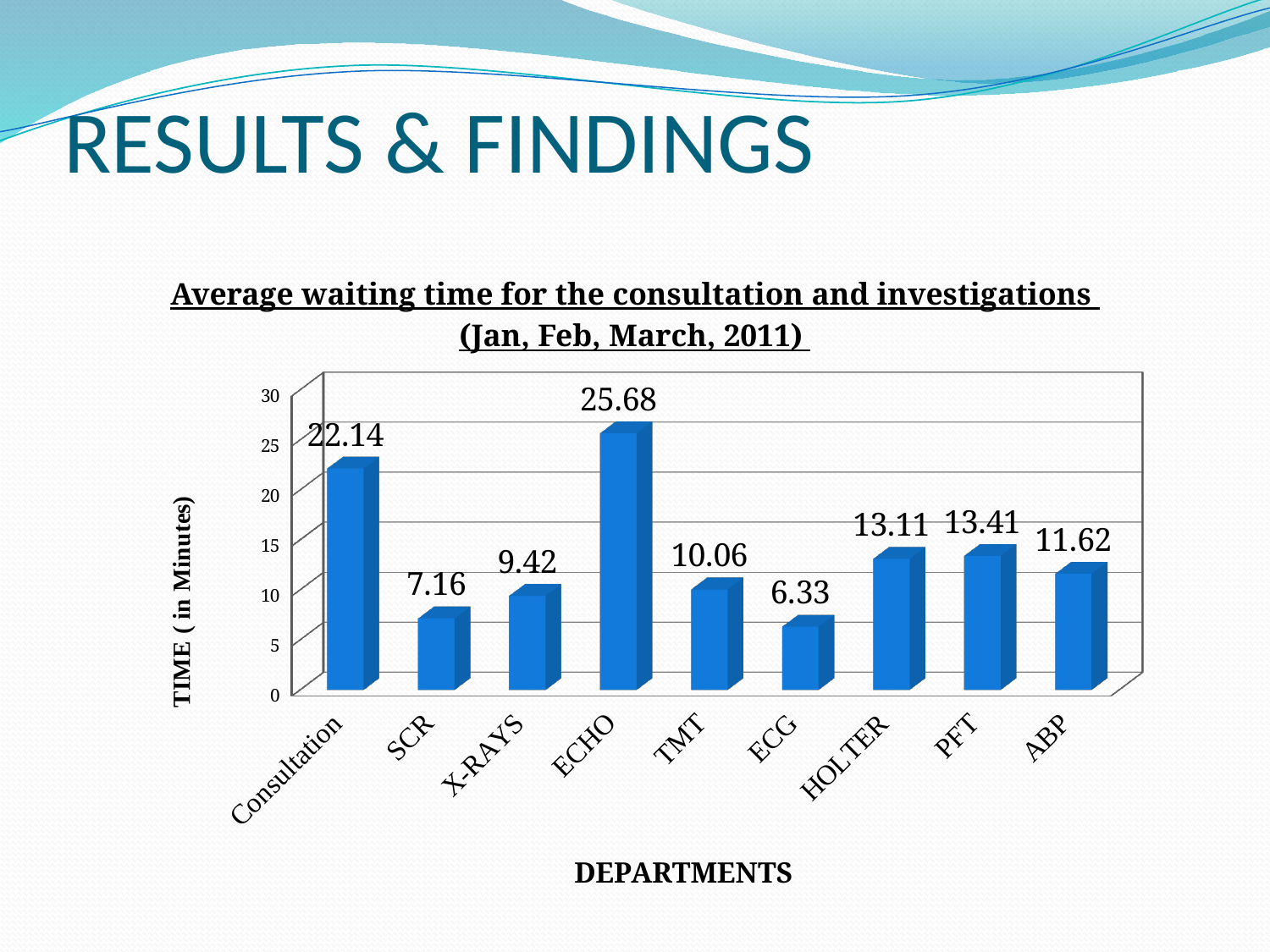
Which department has the lowest average waiting time? ECG Which has a longer average waiting time, PFT or ABP? PFT What is the difference in average waiting time between X-RAYS and SCR? 2.26 What is the average waiting time for HOLTER? 13.11 What is the label of the vertical axis? TIME ( in Minutes) How many departments are shown on the chart? 9 What type of chart is shown on the slide? Bar chart Which department has the highest average waiting time? ECHO Is the average waiting time for TMT greater or less than 15? less What is the difference in average waiting time between ECHO and Consultation? 3.54 What is the average waiting time for ECHO? 25.68 What is the average waiting time for Consultation? 22.14